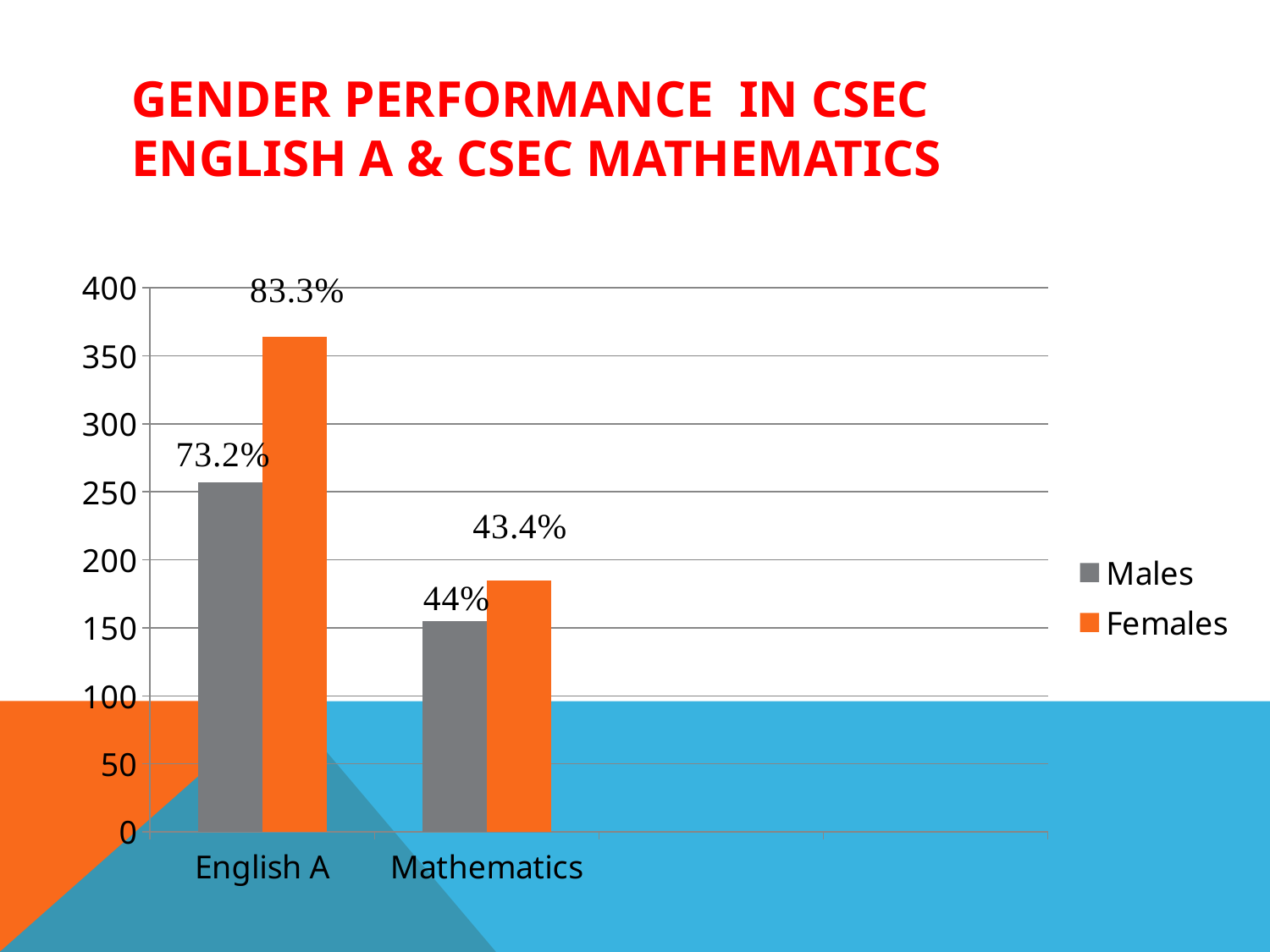
What percentage is printed for Females in Mathematics? 43.4% What percentage is printed for Males in Mathematics? 44% What percentage is printed for Males in English A? 73.2% Which colour represents Females in the legend? orange How many subject categories are shown on the x axis? 2 What percentage is printed for Females in English A? 83.3% Which bar is the tallest in the chart? Females, English A Is the Females bar for English A greater or less than 350 on the axis? greater Which bar is the shortest in the chart? Males, Mathematics What is the difference between the printed percentages for Females and Males in English A? 10.1% How many series does the legend list? 2 What kind of chart is shown on the slide? bar chart